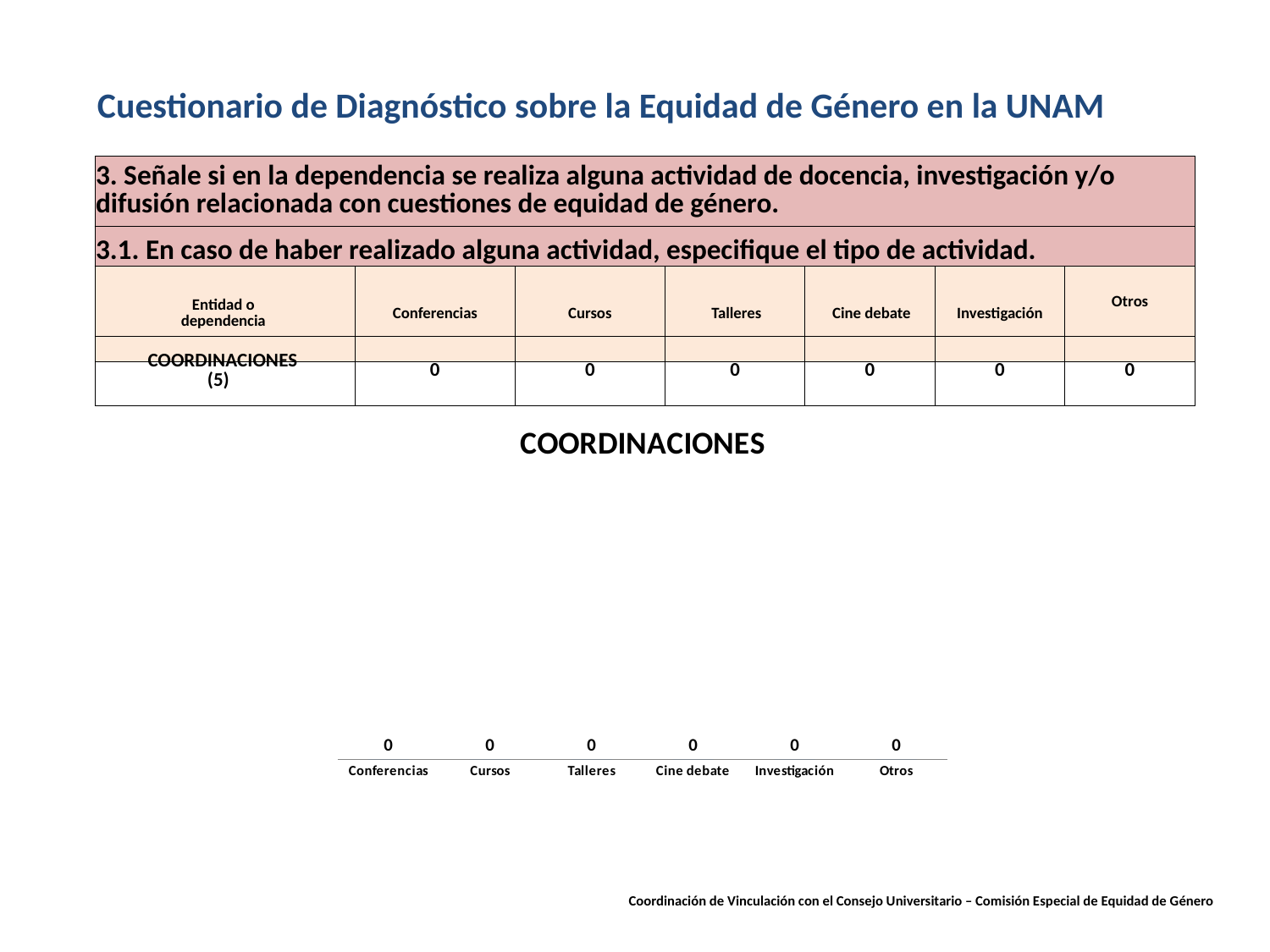
In the COORDINACIONES chart, what is the value for Conferencias? 0 In the COORDINACIONES chart, what is the value for Otros? 0 How many categories are shown on the x axis of the COORDINACIONES chart? 6 What is the title of the chart on the slide? COORDINACIONES In the COORDINACIONES chart, what is the value for Cine debate? 0 In the COORDINACIONES chart, what is the value for Talleres? 0 In the COORDINACIONES chart, what is the value for Investigación? 0 What is the difference between the values for Conferencias and Otros in the COORDINACIONES chart? 0 What is the total of all six values shown in the COORDINACIONES chart? 0 In the COORDINACIONES chart, what is the value for Cursos? 0 Which category appears first (leftmost) on the x axis of the COORDINACIONES chart? Conferencias